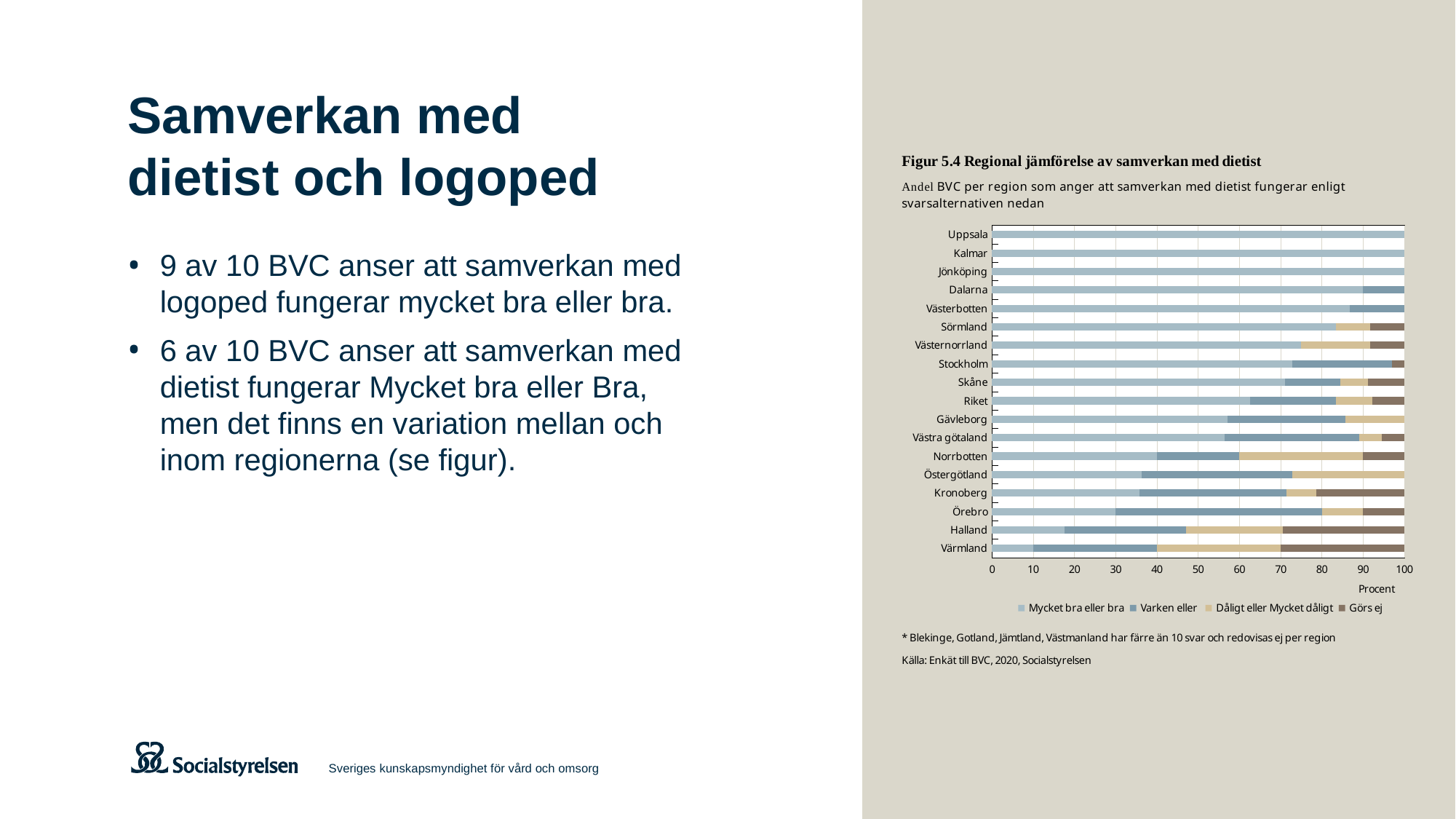
What kind of chart is shown in Figur 5.4? Stacked bar chart How many regions (categories) are listed on the y axis of the chart? 18 Is the 'Mycket bra eller bra' value for Riket greater or less than 60? greater Which region has a larger share of 'Mycket bra eller bra', Kalmar or Örebro? Kalmar Which region has the highest share of 'Mycket bra eller bra'? Uppsala, Kalmar and Jönköping (tied at 100%) Which region has a larger share of 'Mycket bra eller bra', Halland or Värmland? Halland How many series does the chart legend list? 4 Is the 'Mycket bra eller bra' value for Halland greater or less than 30? less Which region has the lowest share of 'Mycket bra eller bra'? Värmland Is the 'Mycket bra eller bra' value for Värmland greater or less than 20? less What is the label on the x axis of the chart? Procent